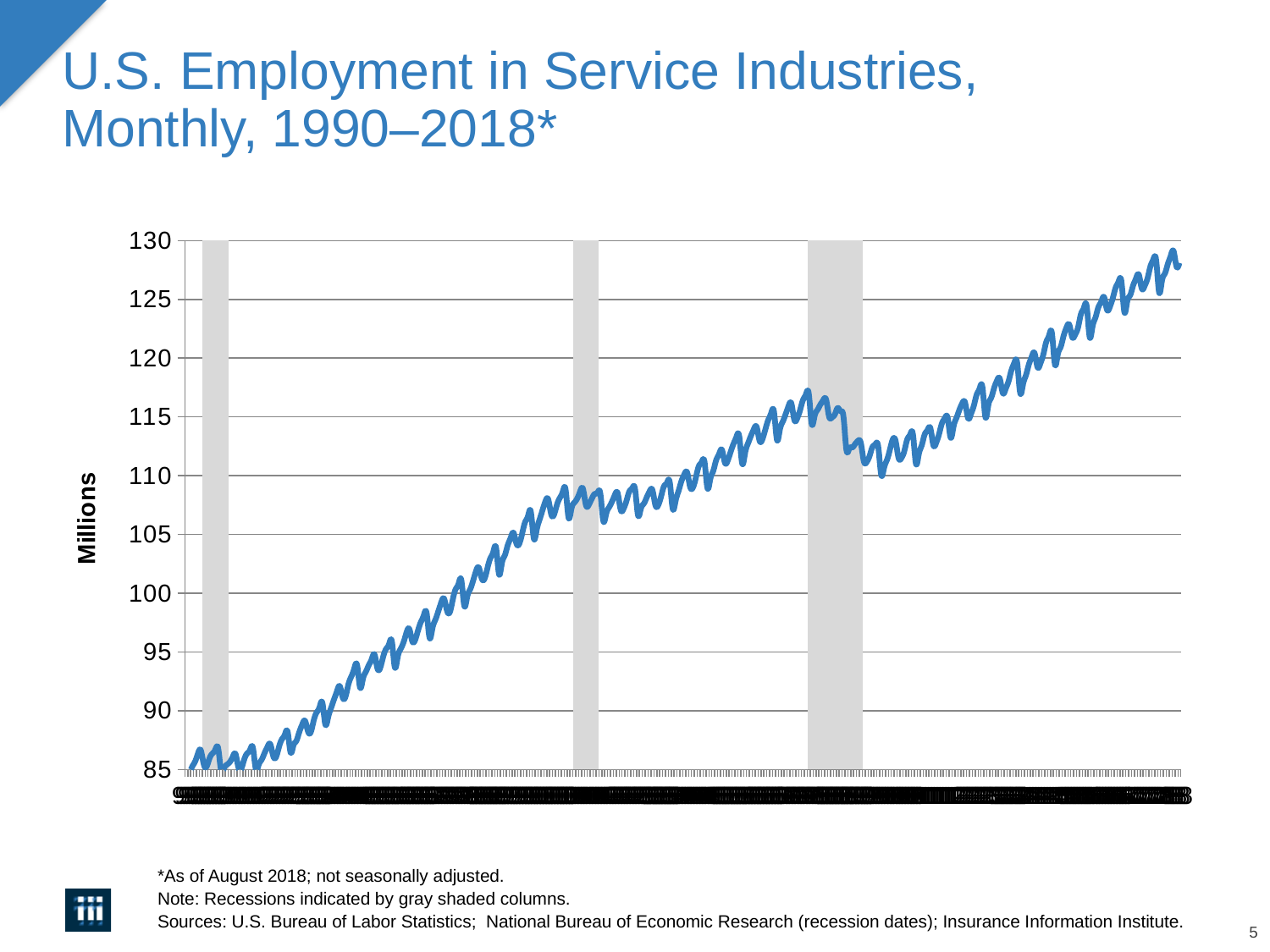
What is the label on the vertical axis? Millions How many gray shaded recession columns are shown on the chart? 3 Is the value at the end of the series (2018) greater or less than 125? greater What is the title of the chart? U.S. Employment in Service Industries, Monthly, 1990–2018* Is the highest point of the line greater or less than 130? less What is the lowest value shown on the vertical axis? 85 Do the values generally rise or fall from the start of the series to the end? rise What is the highest value shown on the vertical axis? 130 Is the value at the start of the series (1990) greater or less than 90? less How many lines are plotted on the chart? 1 What kind of chart is shown on the slide? line chart